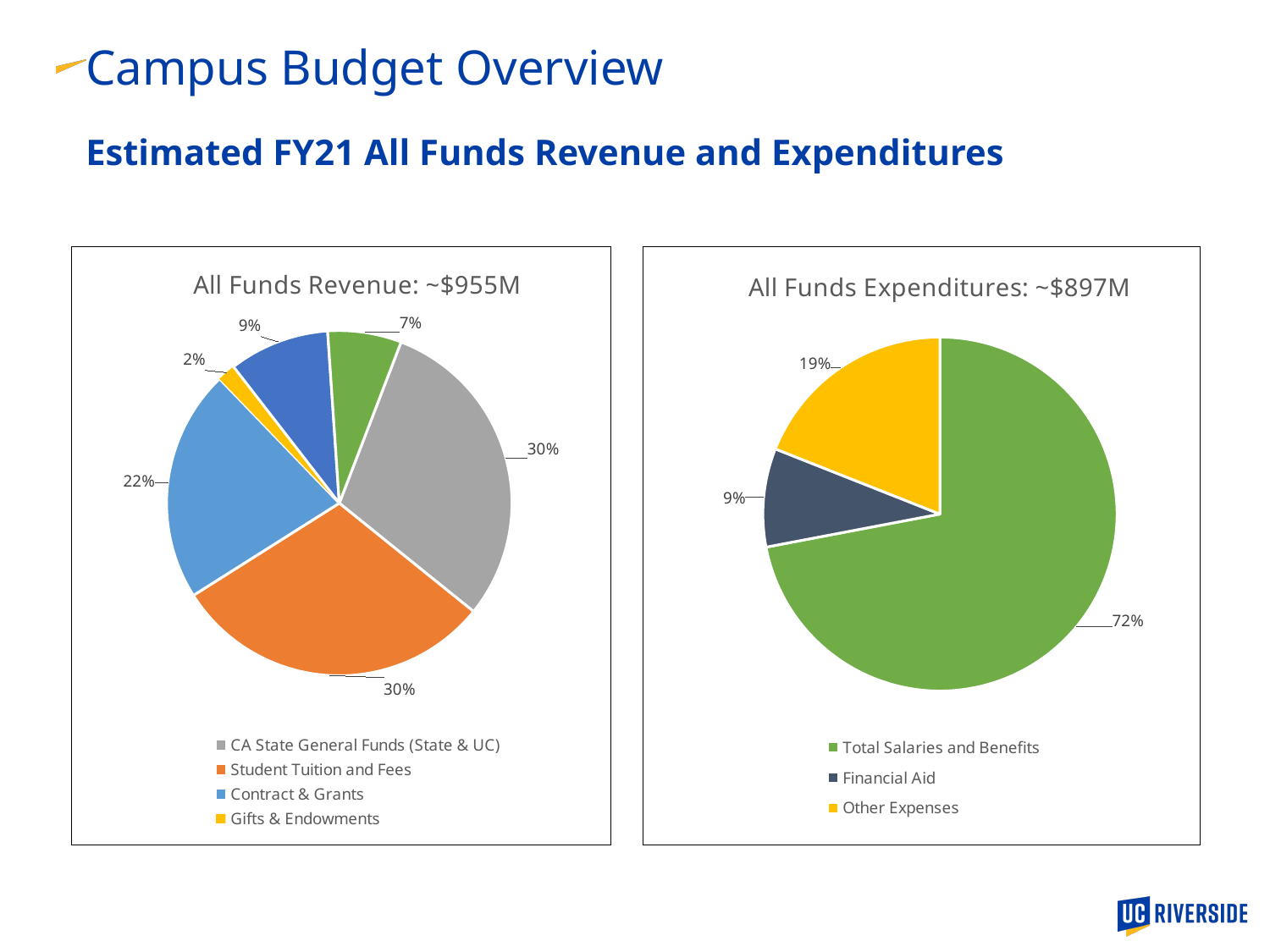
In the All Funds Expenditures chart, what share of expenditures is Other Expenses? 19% In the All Funds Revenue chart, what share of revenue comes from Contract & Grants? 22% In the All Funds Expenditures chart, which category has the largest share? Total Salaries and Benefits In the All Funds Expenditures chart, what share of expenditures is Financial Aid? 9% In the All Funds Revenue chart, which legend category has the smallest share? Gifts & Endowments What is the approximate total shown in the title of the All Funds Expenditures chart? ~$897M In the All Funds Expenditures chart, how many percentage points larger is Total Salaries and Benefits than Other Expenses? 53 percentage points How many slices does the All Funds Expenditures pie chart have? 3 What type of chart is used for All Funds Revenue? Pie chart In the All Funds Revenue chart, what share of revenue comes from Gifts & Endowments? 2% In the All Funds Revenue chart, which is larger: Contract & Grants or Gifts & Endowments? Contract & Grants In the All Funds Revenue chart, what share of revenue comes from Student Tuition and Fees? 30%